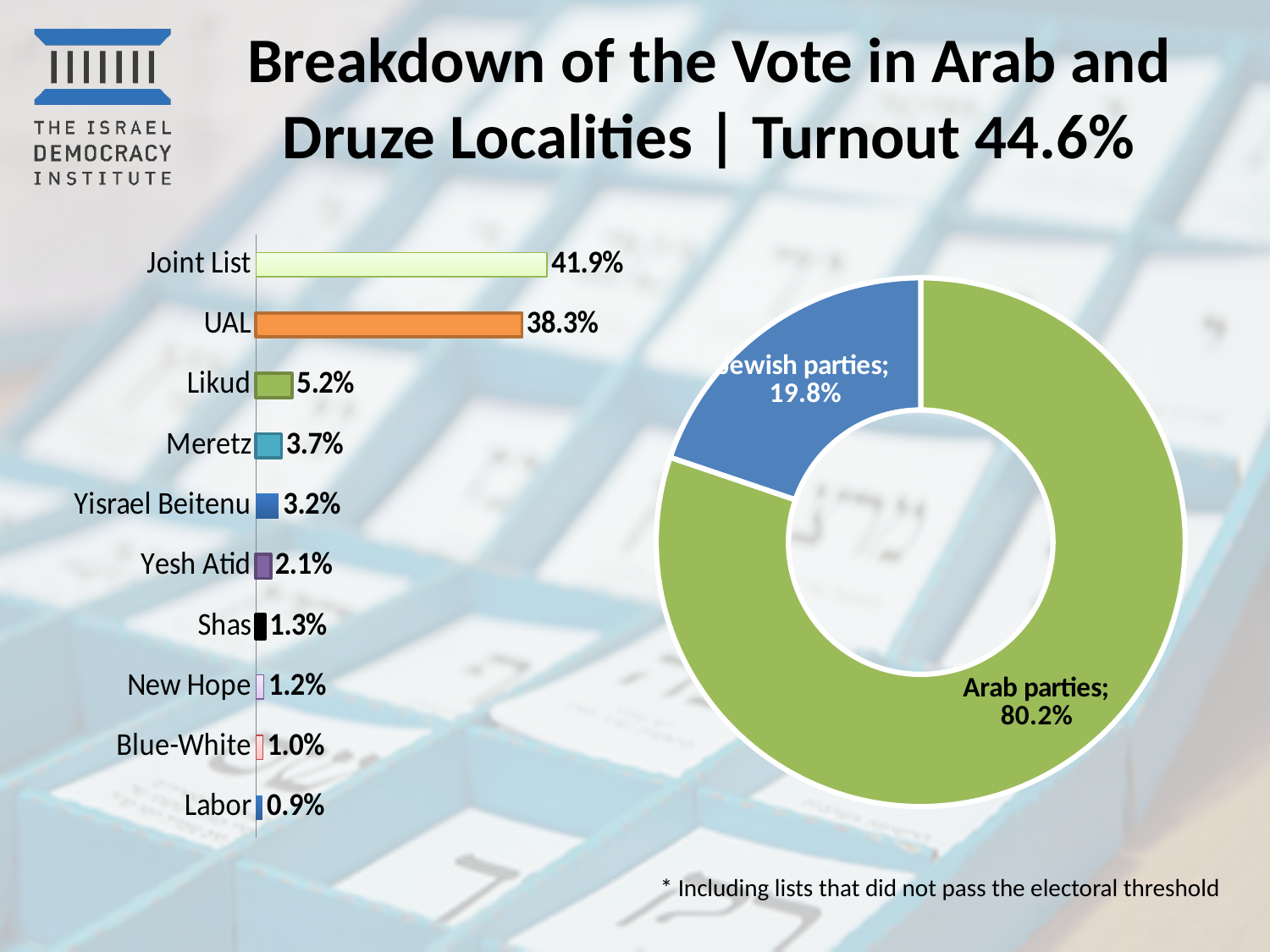
What turnout figure is given in the slide title? 44.6% In the bar chart on the left, which party has the lowest value? Labor In the bar chart on the left, which party has the highest value? Joint List How many parties are shown in the bar chart on the left? 10 In the bar chart on the left, what is the value for Meretz? 3.7% In the bar chart on the left, what is the value for UAL? 38.3% In the bar chart on the left, what is the value for Joint List? 41.9% In the doughnut chart on the right, what share do Arab parties have? 80.2% In the bar chart on the left, what is the difference between Joint List and UAL? 3.6% What kind of chart is on the left of the slide? Bar chart In the bar chart on the left, which is larger, Likud or Meretz? Likud In the doughnut chart on the right, what share do Jewish parties have? 19.8%